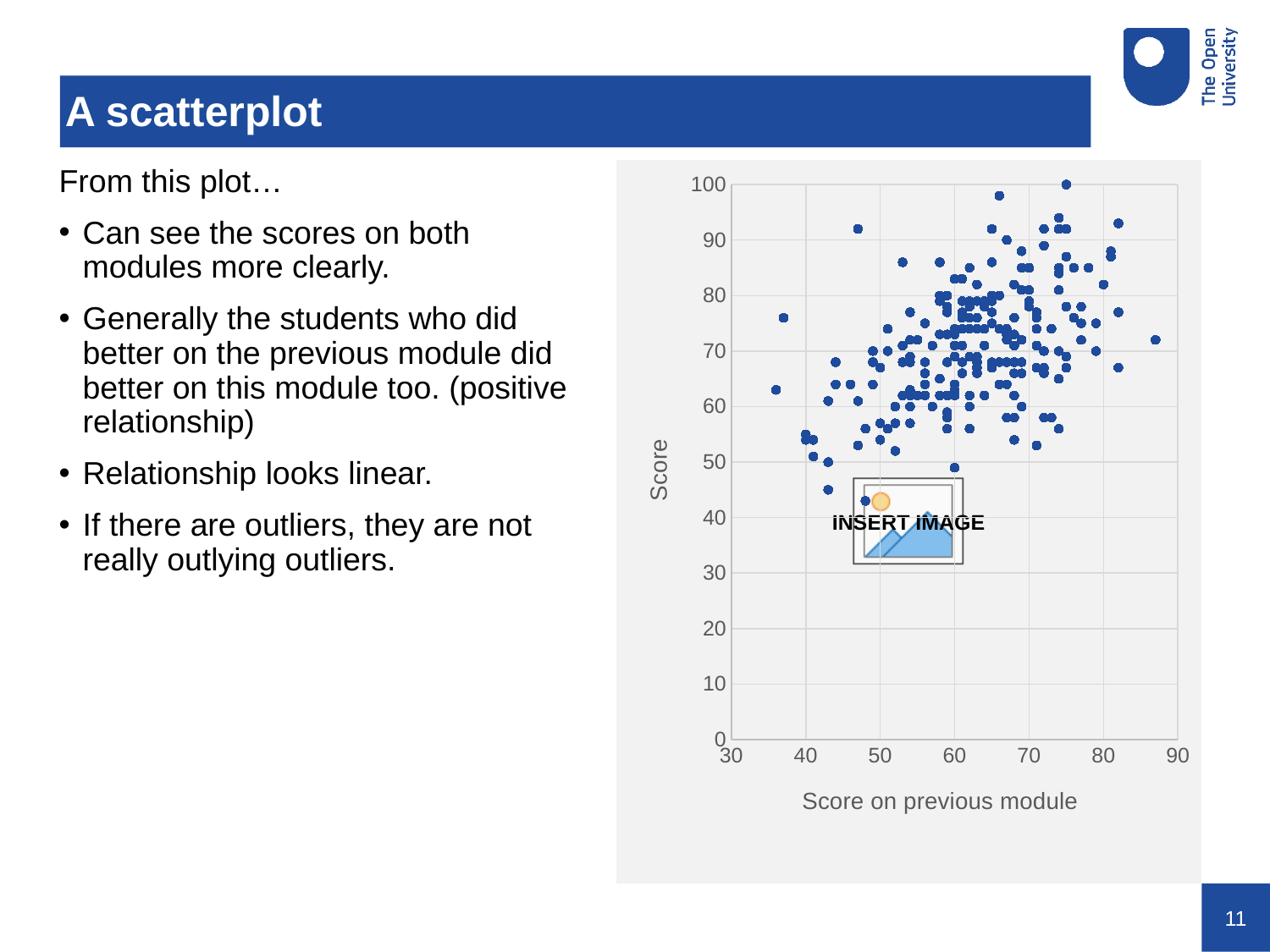
As the score on the previous module increases, does the Score generally rise or fall? Rise Are any points plotted with a Score below 30? No Is the smallest score on the previous module plotted greater or less than 40? less What kind of chart is shown on the slide? Scatter plot Is the largest score on the previous module plotted greater or less than 80? greater What is the title of the vertical axis of the chart? Score What is the title of the horizontal axis of the chart? Score on previous module